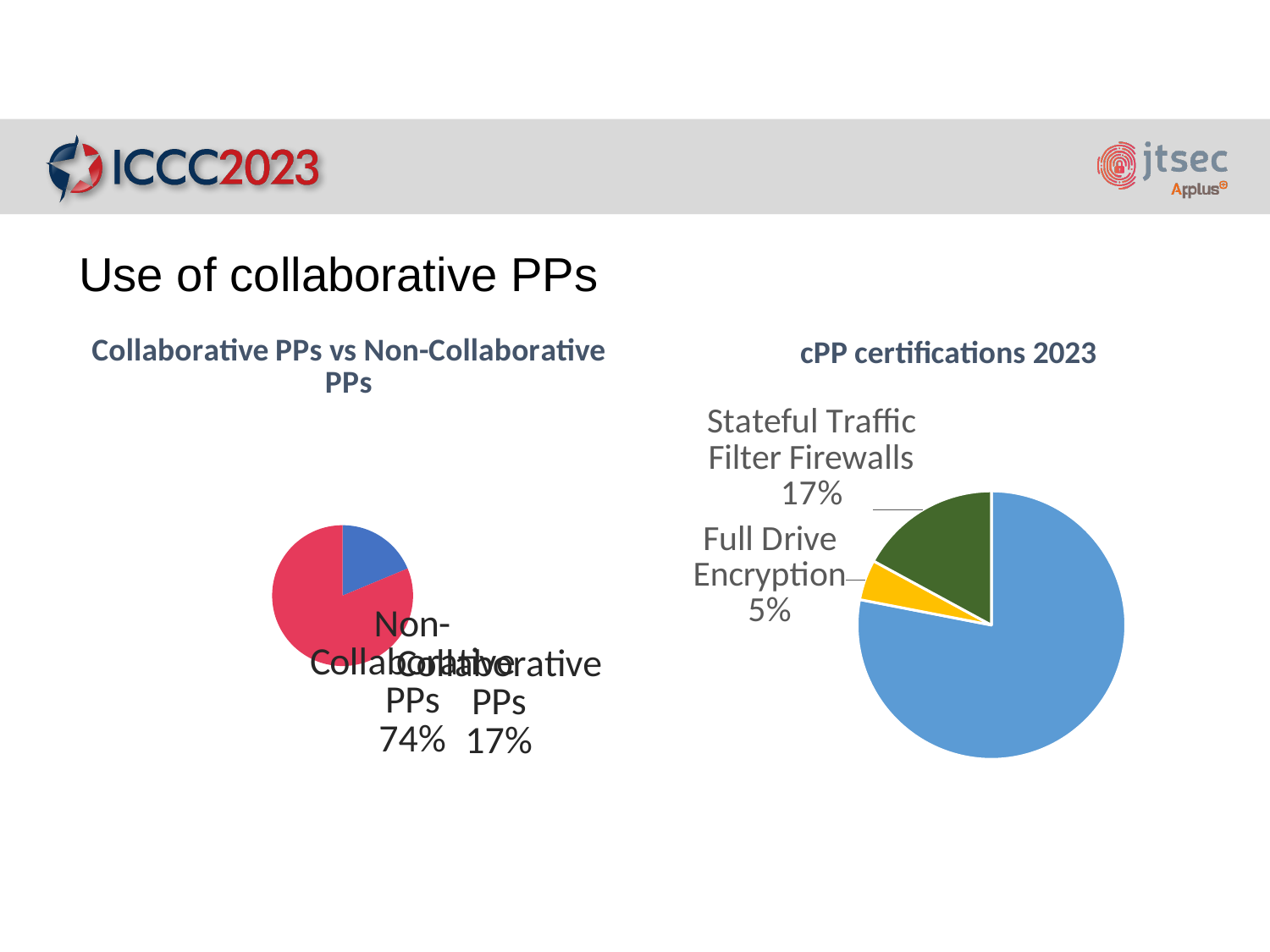
In the 'cPP certifications 2023' chart, which is larger: Stateful Traffic Filter Firewalls or Full Drive Encryption? Stateful Traffic Filter Firewalls What is the title of the pie chart on the right of the slide? cPP certifications 2023 In the 'cPP certifications 2023' chart, which labelled category has the smallest slice? Full Drive Encryption In the 'Collaborative PPs vs Non-Collaborative PPs' chart, what share is labelled for Collaborative PPs? 17% What kind of chart is the 'Collaborative PPs vs Non-Collaborative PPs' chart? pie chart In the 'Collaborative PPs vs Non-Collaborative PPs' chart, which slice is larger: Collaborative PPs or Non-Collaborative PPs? Non-Collaborative PPs What kind of chart is the 'cPP certifications 2023' chart? pie chart In the 'cPP certifications 2023' chart, what share is labelled for Stateful Traffic Filter Firewalls? 17% In the 'cPP certifications 2023' chart, what is the difference in percentage points between Stateful Traffic Filter Firewalls and Full Drive Encryption? 12% In the 'cPP certifications 2023' chart, what share is labelled for Full Drive Encryption? 5% How many slices does the 'Collaborative PPs vs Non-Collaborative PPs' pie chart have? 2 How many slices does the 'cPP certifications 2023' pie chart have? 3